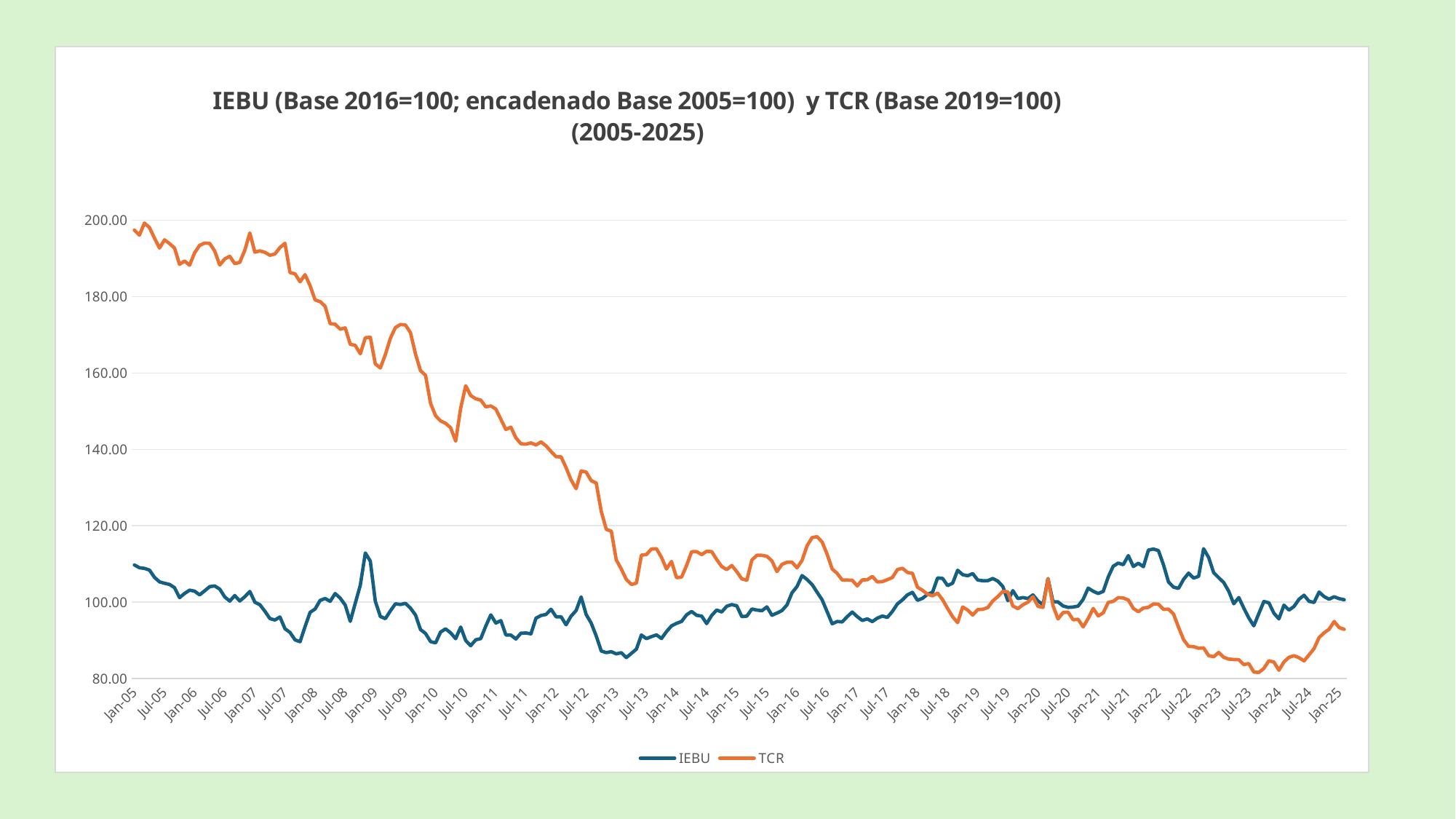
What kind of chart is shown on the slide? line chart What are the two series named in the legend? IEBU and TCR Is the value of TCR at Jan-10 greater or less than 140? greater Does the TCR series generally rise or fall from Jan-05 to Jan-13? fall Is the value of IEBU at Jan-13 greater or less than 100? less At Jan-05, which series has the larger value, IEBU or TCR? TCR Is the value of TCR at Jan-05 greater or less than 180? greater At Jan-23, which series has the larger value, IEBU or TCR? IEBU How many series does the legend list? 2 Which colour is used for the TCR line? orange